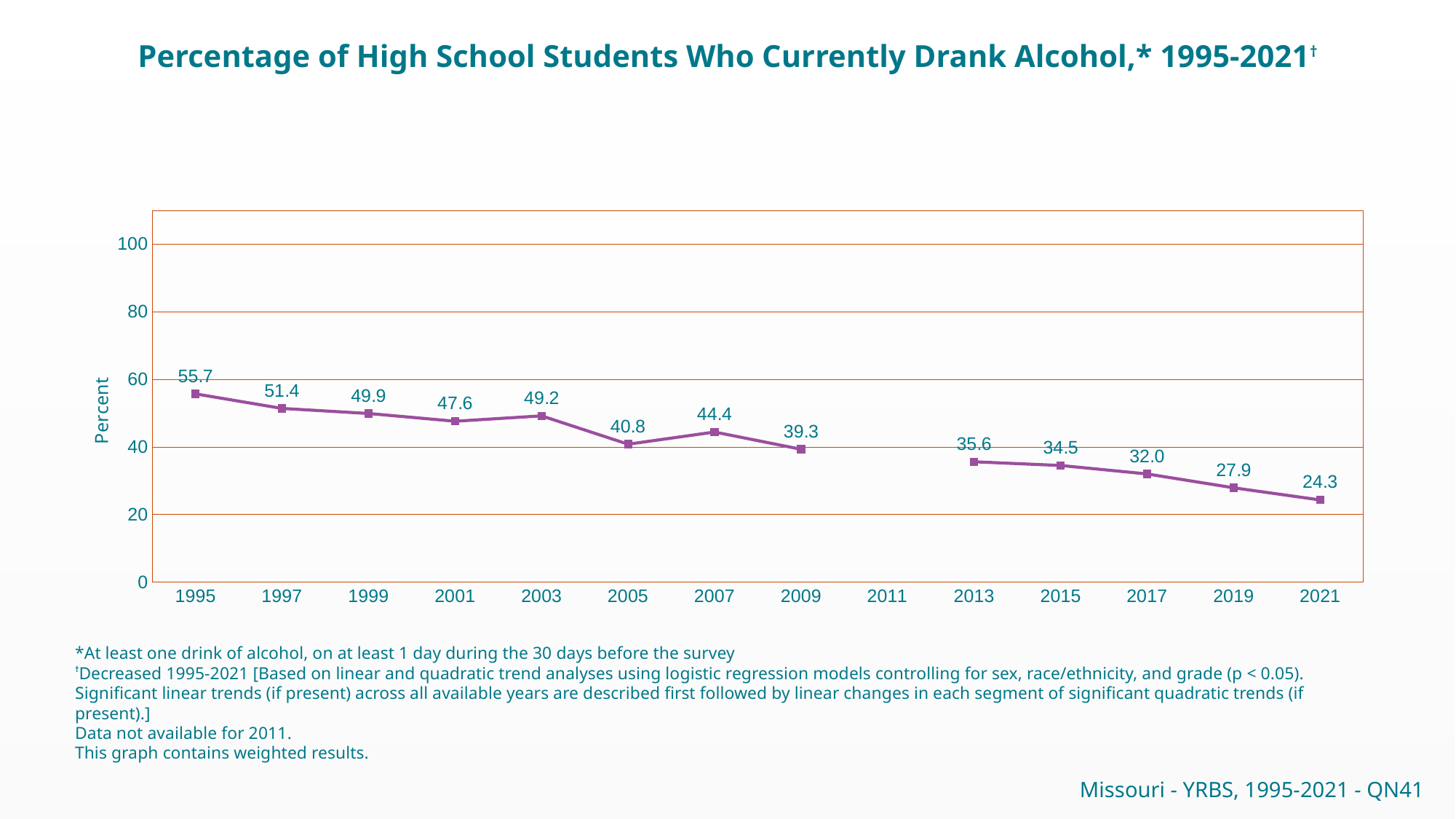
What was the percentage of high school students who currently drank alcohol in 1995? 55.7 What is the difference between the 1995 value and the 2021 value? 31.4 Which year has the highest percentage of students who currently drank alcohol? 1995 Which year has a higher value, 2003 or 2007? 2003 Which year has the lowest percentage of students who currently drank alcohol? 2021 For which year on the x axis is data not available? 2011 Is the value for 2013 greater or less than 40? less What was the percentage of high school students who currently drank alcohol in 2021? 24.3 Do the values generally rise or fall from 1995 to 2021? fall How many years have data points plotted on the chart? 13 What kind of chart is shown on the slide? line chart What value is shown for 2005? 40.8